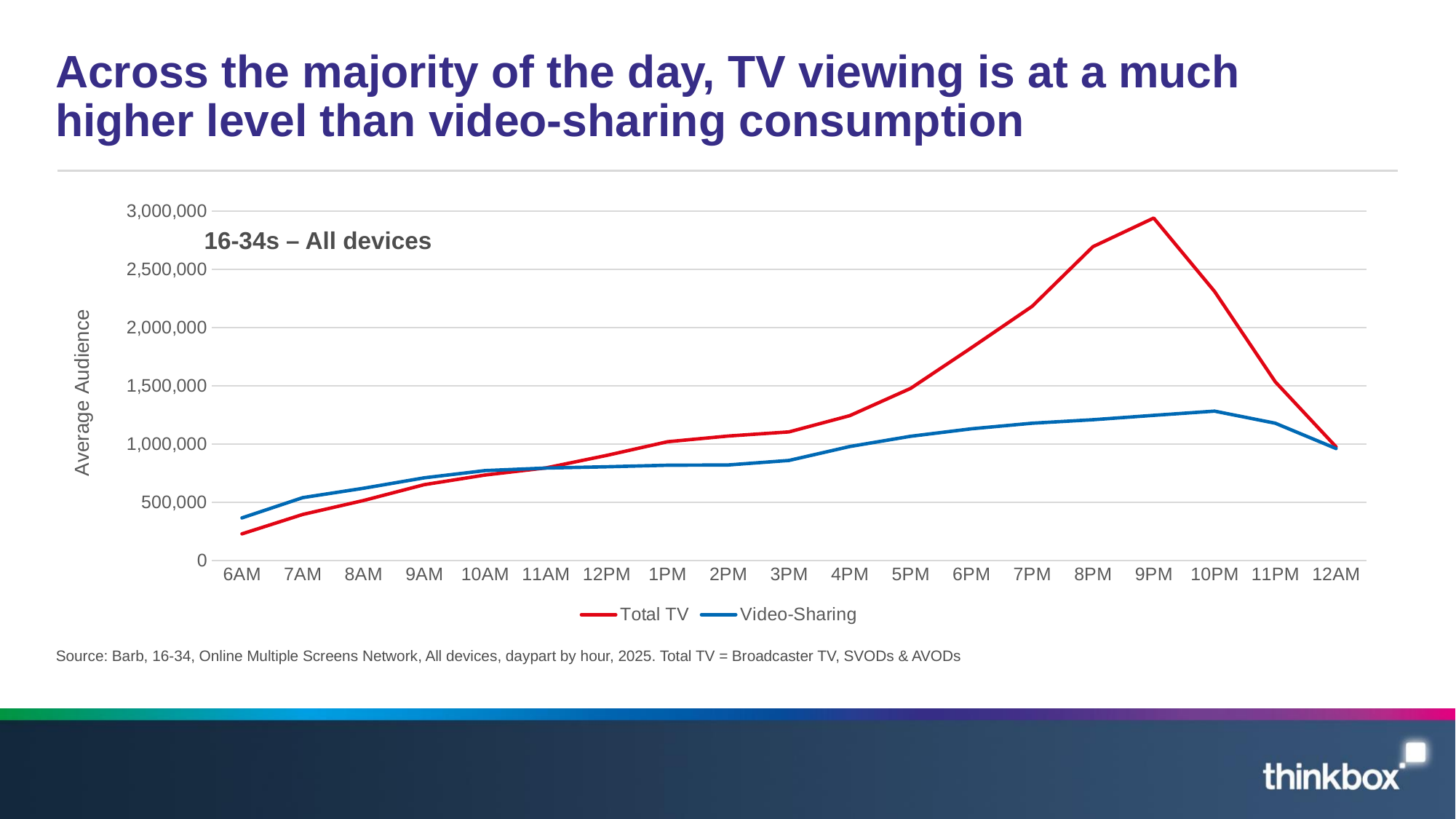
Is the Total TV value at 7PM greater or less than 2,000,000? greater At which hour does the Total TV line reach its highest value? 9PM At which hour is the Total TV value lowest? 6AM Is the Video-Sharing value at 10PM greater or less than 1,500,000? less How many hourly points are plotted along the x axis? 19 What kind of chart is shown on the slide? Line chart Does the Total TV line rise or fall between 6AM and 9PM? Rise At 7AM, which series has the higher value, Total TV or Video-Sharing? Video-Sharing At which hour does the Video-Sharing line reach its highest value? 10PM How many series does the legend list? 2 What colour is the Total TV line? Red Is the Total TV value at 9PM greater or less than 2,500,000? greater